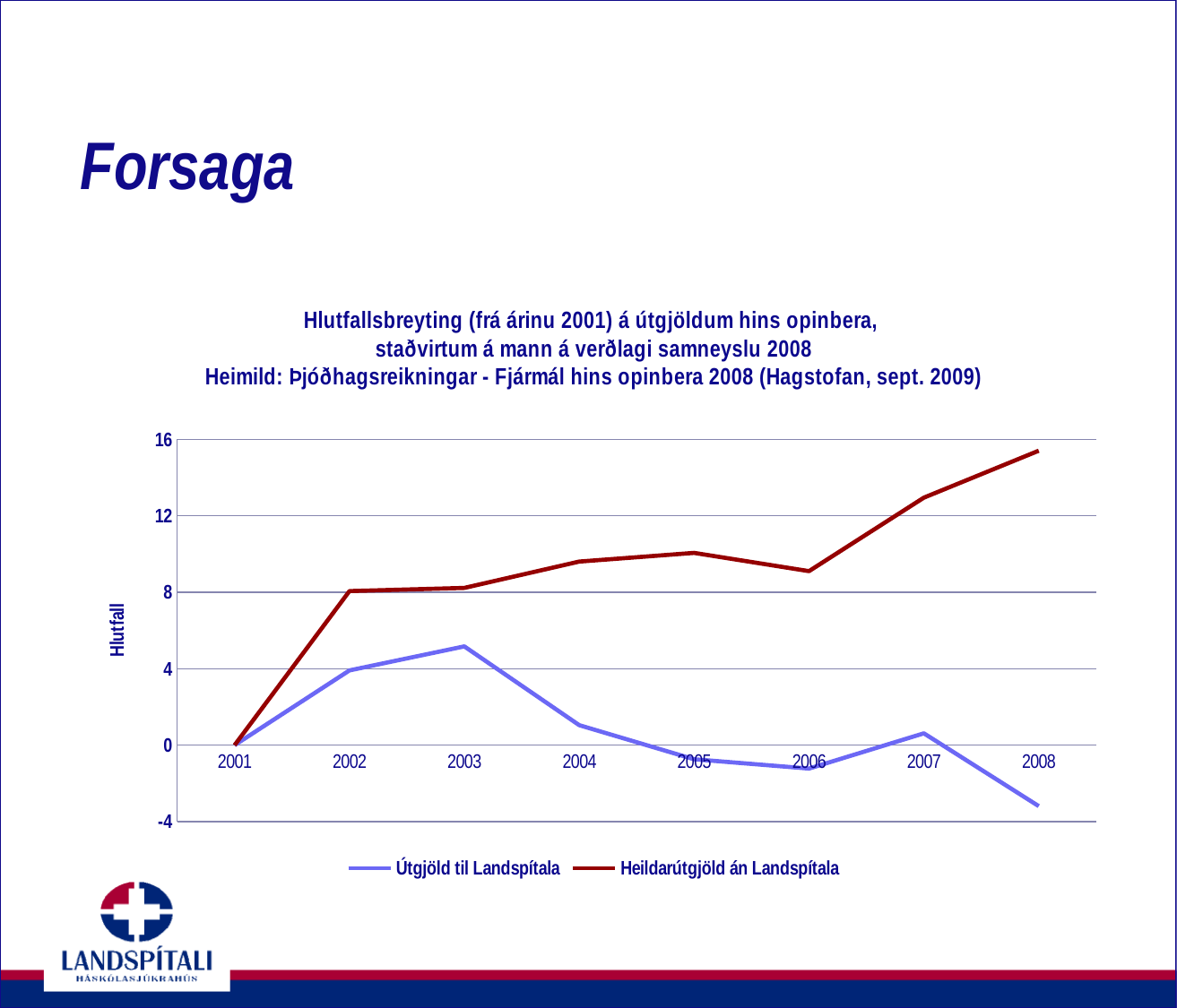
What is the label on the y axis? Hlutfall How many years are plotted along the x axis? 8 Is the value for Útgjöld til Landspítala in 2003 greater or less than 4? greater In which year is Útgjöld til Landspítala highest? 2003 What is the value for Útgjöld til Landspítala in 2001? 0 In which year is Útgjöld til Landspítala lowest? 2008 Is the value for Heildarútgjöld án Landspítala in 2008 greater or less than 12? greater How many series does the legend list? 2 In 2008, which series has the larger value, Útgjöld til Landspítala or Heildarútgjöld án Landspítala? Heildarútgjöld án Landspítala In which year is Heildarútgjöld án Landspítala highest? 2008 Is the value for Útgjöld til Landspítala in 2008 greater or less than 0? less What kind of chart is shown on the slide? line chart